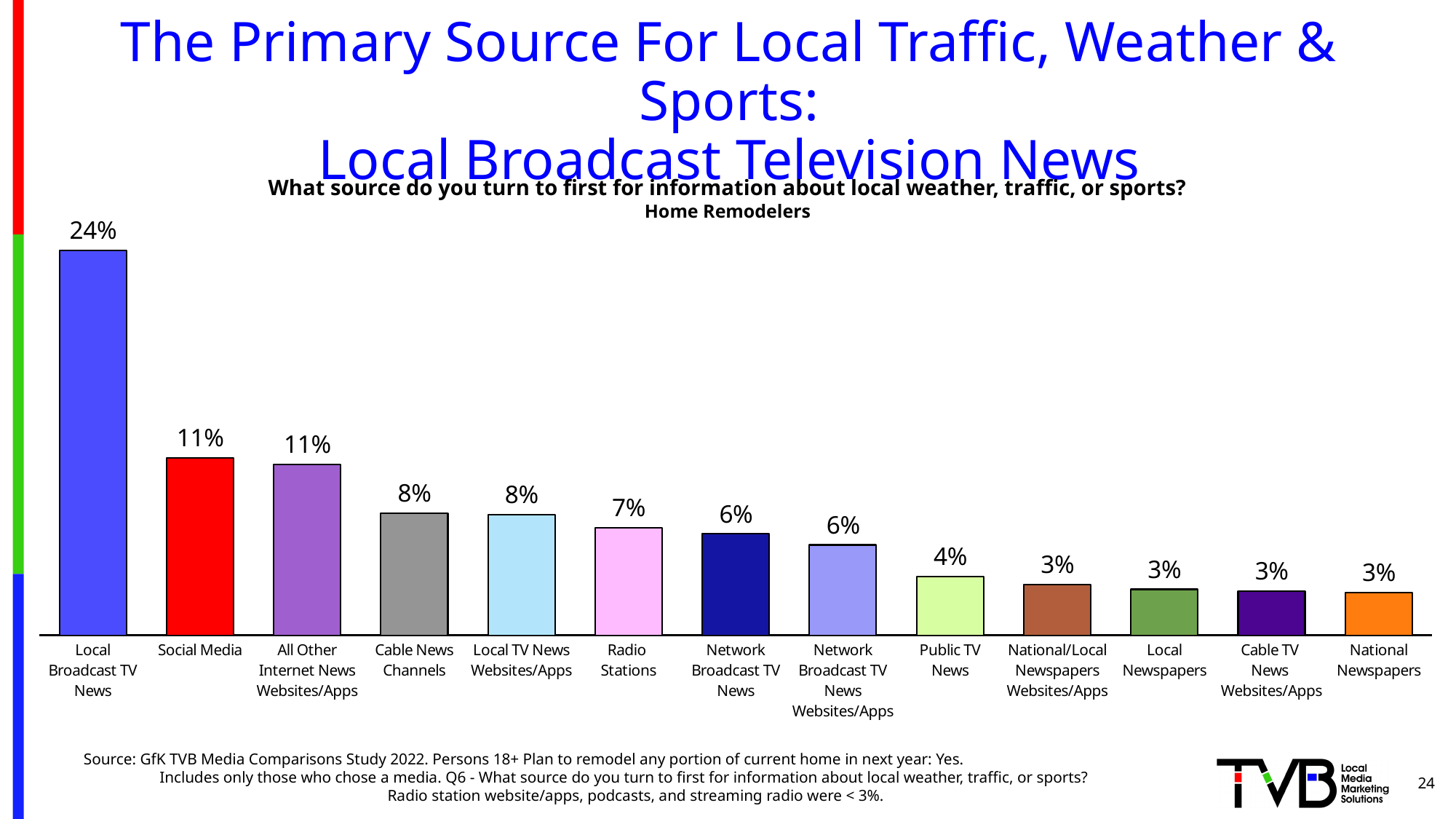
What is the value shown for Radio Stations? 7% Which source has the highest value on the chart? Local Broadcast TV News What is the value shown for Public TV News? 4% What kind of chart is shown on the slide? Bar chart How many sources (categories) are shown on the chart? 13 Which is larger, the value for Network Broadcast TV News or the value for Public TV News? Network Broadcast TV News Do the values generally rise or fall moving from left to right across the chart? Fall What is the difference between the values for Cable News Channels and Public TV News? 4% What is the value shown for Social Media? 11% What percentage of Home Remodelers turn first to Local Broadcast TV News for local weather, traffic, or sports? 24% What is the difference between the values for Local Broadcast TV News and Social Media? 13% Which group of respondents does the chart describe, according to the subtitle? Home Remodelers